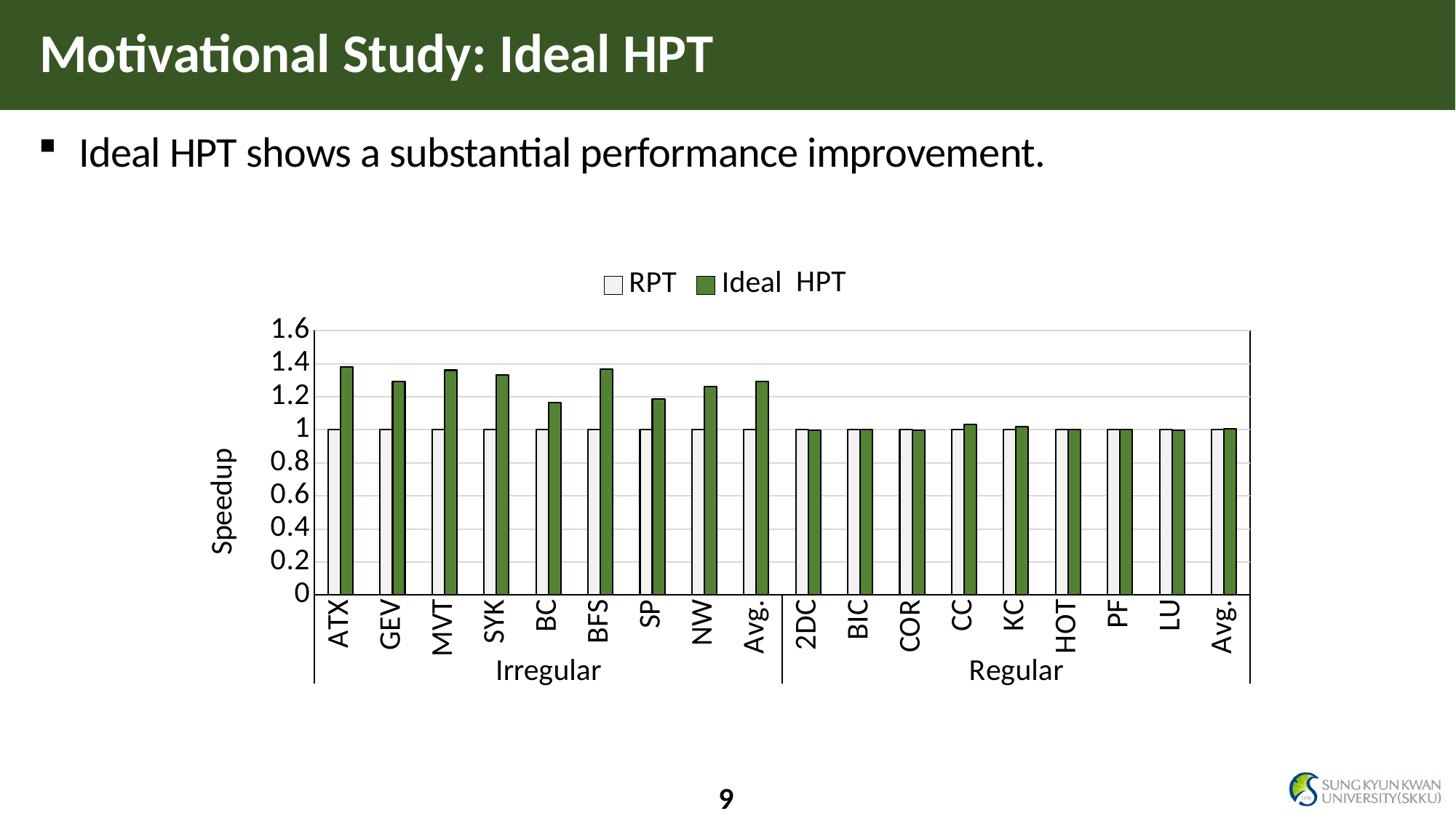
Is the Ideal HPT value for ATX greater or less than 1.2? greater What is the label of the y axis? Speedup What is the RPT speedup value for HOT? 1 Which is larger, the Ideal HPT value for the Irregular Avg. or the Ideal HPT value for the Regular Avg.? Irregular Avg. Is the Ideal HPT value for GEV greater or less than 1.2? greater How many benchmark categories are shown along the x axis? 18 What kind of chart is shown on the slide? bar chart Which is larger, the Ideal HPT value for ATX or the Ideal HPT value for BC? ATX Is the Ideal HPT value for 2DC greater or less than 1.2? less What are the two series named in the legend? RPT and Ideal HPT What is the RPT speedup value for ATX? 1 How many series does the legend list? 2